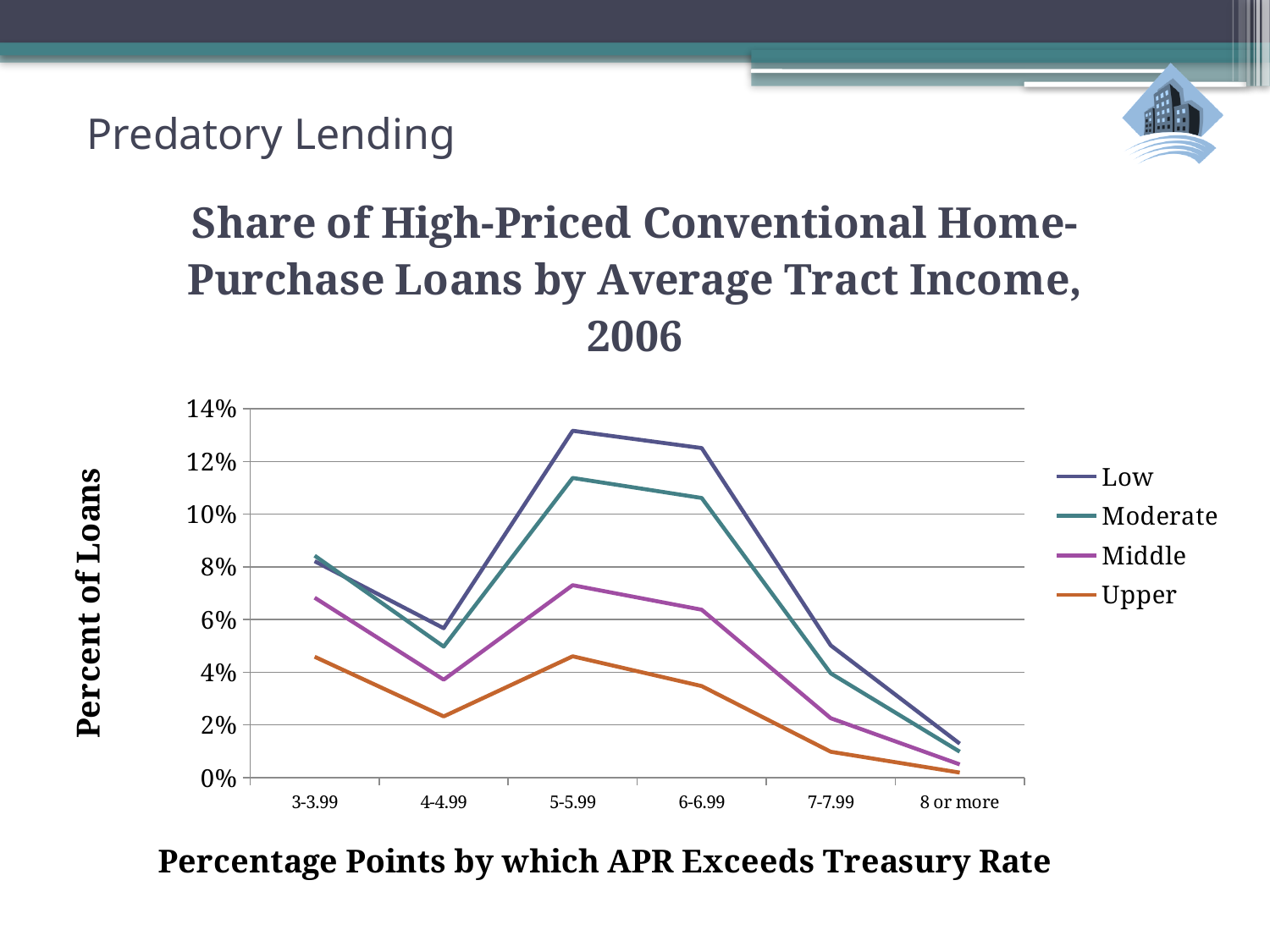
At 6-6.99, which series has the larger value, Low or Middle? Low How many series does the legend list? 4 Is the value for Low at 5-5.99 greater or less than 12%? greater At 3-3.99, which series has the larger value, Upper or Middle? Middle Is the value for Moderate at 5-5.99 greater or less than 10%? greater From 6-6.99 to 8 or more, does the Moderate series rise or fall? fall For the Low series, which category has the highest value? 5-5.99 What is the title of the y axis? Percent of Loans How many categories are shown on the x axis? 6 For the Low series, which category has the lowest value? 8 or more Is the value for Upper at 4-4.99 greater or less than 4%? less What kind of chart is shown on the slide? line chart